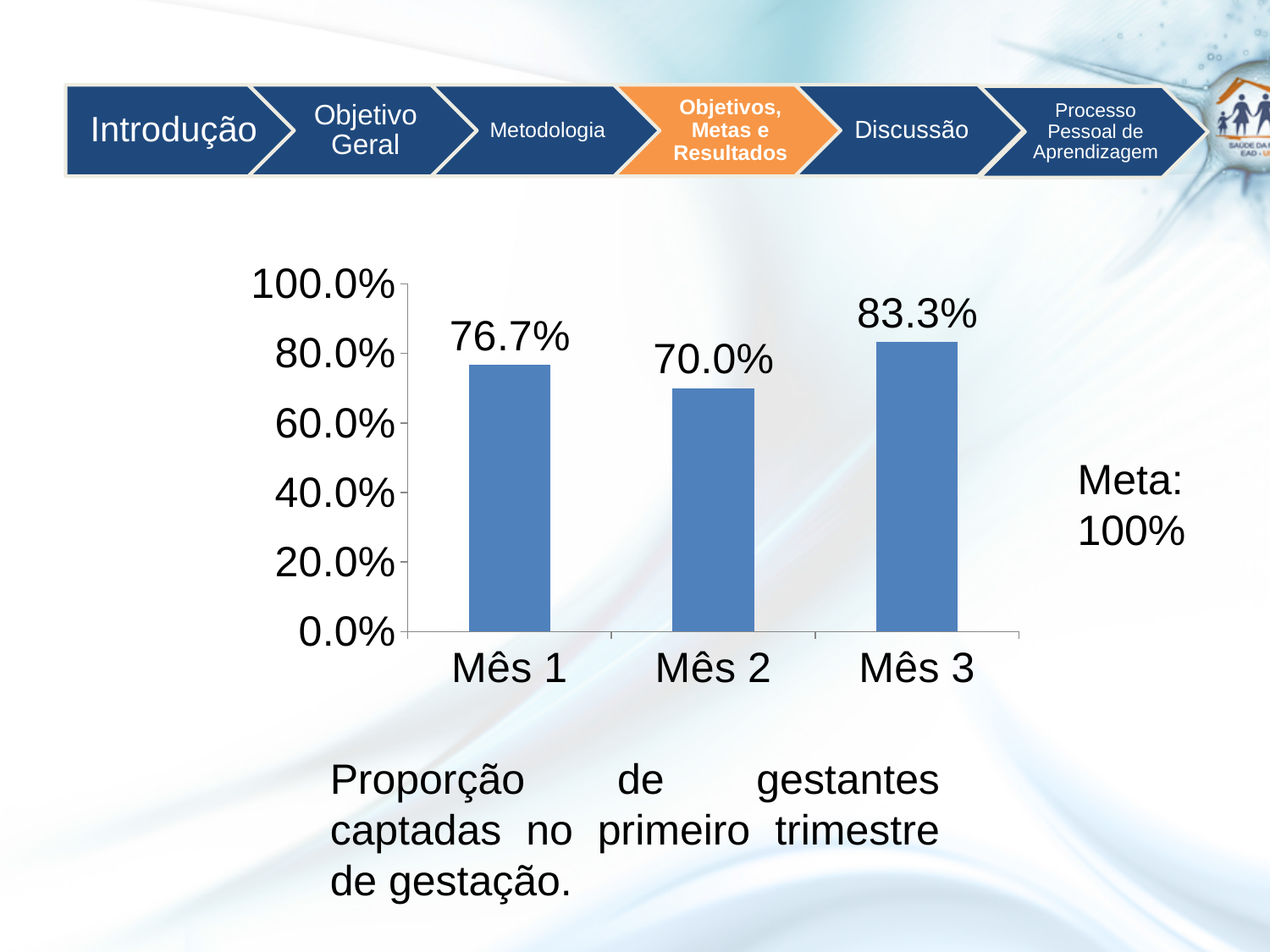
Which is larger, the value for Mês 1 or the value for Mês 3? Mês 3 Is the value for Mês 2 greater or less than 80.0%? less Which month has the highest value? Mês 3 What kind of chart is shown on the slide? bar chart What is the difference between the values for Mês 1 and Mês 2? 6.7% Which month has the lowest value? Mês 2 What is the value for Mês 1? 76.7% What is the value for Mês 3? 83.3% What is the difference between the values for Mês 3 and Mês 2? 13.3% How many months are shown on the x axis? 3 What is the value for Mês 2? 70.0% What target (Meta) is stated next to the chart? 100%